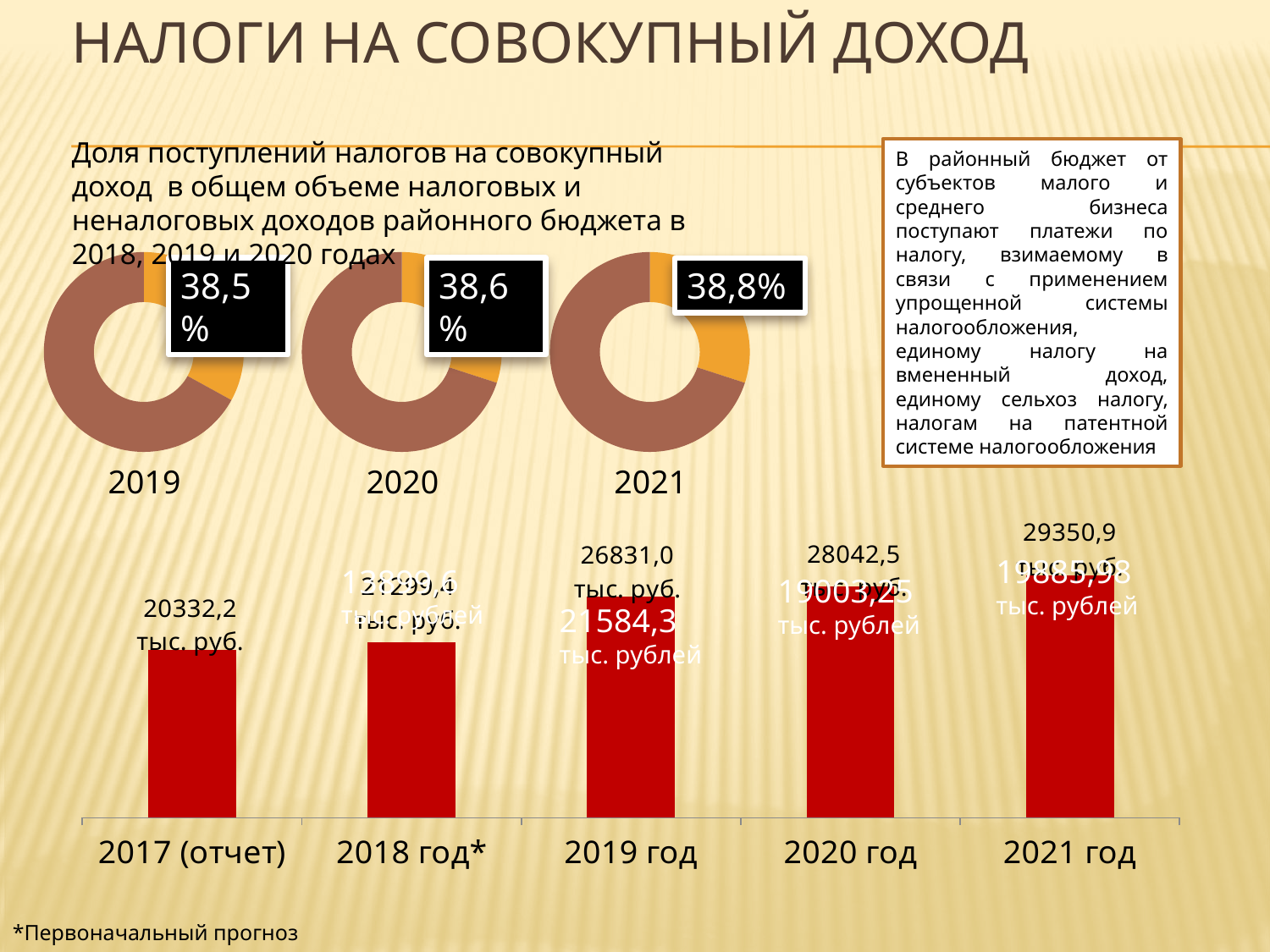
In the donut chart labelled 2019, what share is shown in the data label? 38,5% In the bottom bar chart, which year has the lowest value? 2017 (отчет) In the bottom bar chart, what is the difference between the values for 2021 год and 2017 (отчет)? 9018,7 тыс. руб. In the bottom bar chart, how many bars (years) are shown? 5 Among the three donut charts (2019, 2020, 2021), which year shows the highest share? 2021 In the bottom bar chart, what is the value for 2017 (отчет)? 20332,2 тыс. руб. In the bottom bar chart, what is the value for 2020 год? 28042,5 тыс. руб. In the bottom bar chart, do the values rise or fall from 2017 to 2021? rise In the bottom bar chart, which year has the highest value? 2021 год In the bottom bar chart, what is the value for 2021 год? 29350,9 тыс. руб. In the bottom bar chart, what is the value for 2019 год? 26831,0 тыс. руб. What kind of chart is the chart at the bottom of the slide showing values by year from 2017 to 2021? bar chart